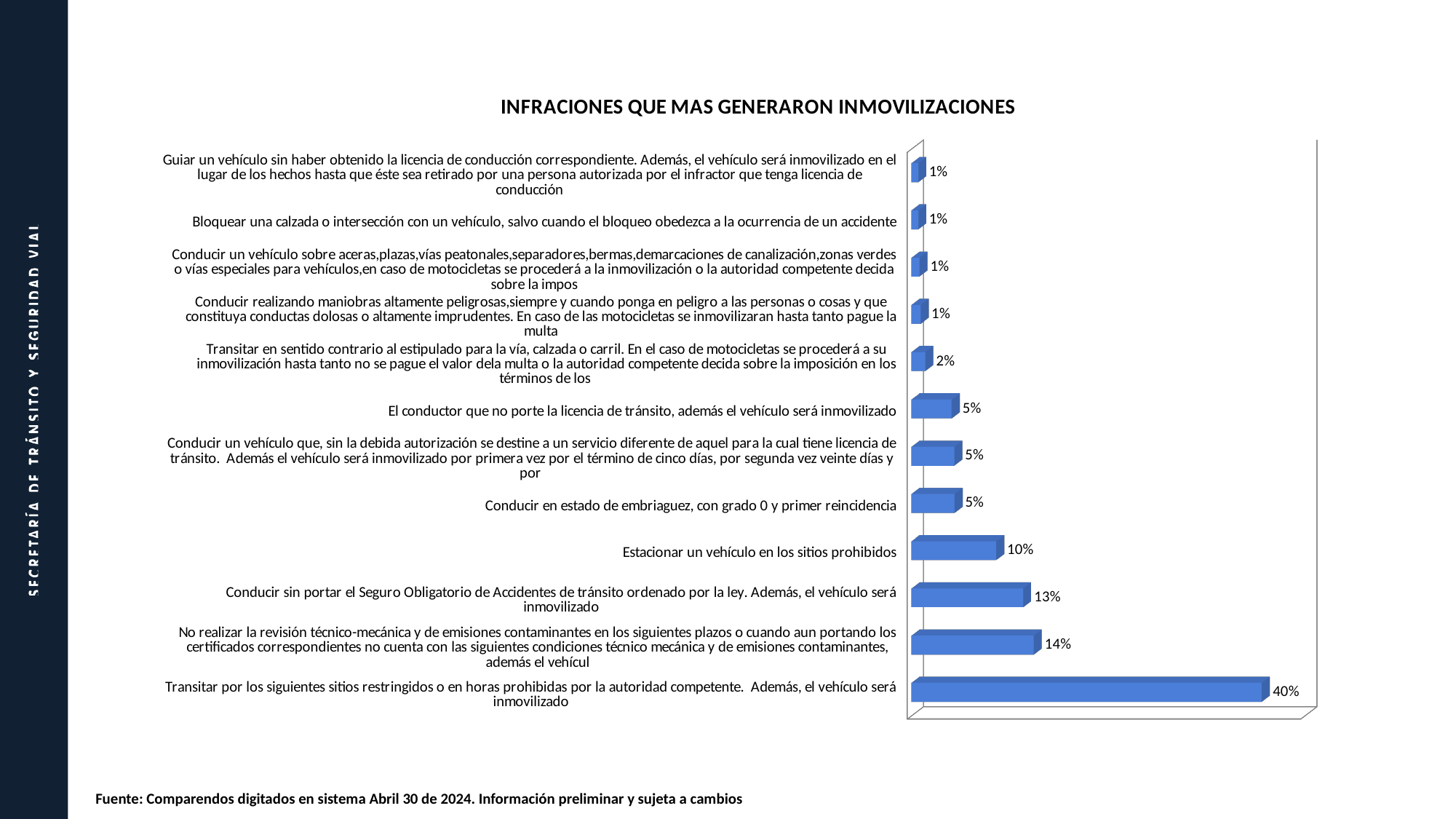
Which infraction has the highest percentage in the chart? Transitar por los siguientes sitios restringidos o en horas prohibidas por la autoridad competente What is the smallest percentage value shown in the chart? 1% What is the value for "Conducir sin portar el Seguro Obligatorio de Accidentes de tránsito ordenado por la ley"? 13% Which is larger: the value for "Estacionar un vehículo en los sitios prohibidos" or the value for "Conducir en estado de embriaguez, con grado 0 y primer reincidencia"? Estacionar un vehículo en los sitios prohibidos What is the value for "Transitar en sentido contrario al estipulado para la vía, calzada o carril"? 2% What is the difference between the value for "Transitar por los siguientes sitios restringidos" and the value for "No realizar la revisión técnico-mecánica"? 26% What is the value for "Estacionar un vehículo en los sitios prohibidos"? 10% What is the title of the chart? INFRACIONES QUE MAS GENERARON INMOVILIZACIONES What type of chart is shown on the slide? Bar chart How many infraction categories are plotted in the chart? 12 What is the value for "Transitar por los siguientes sitios restringidos o en horas prohibidas por la autoridad competente"? 40% What is the value for "Conducir en estado de embriaguez, con grado 0 y primer reincidencia"? 5%